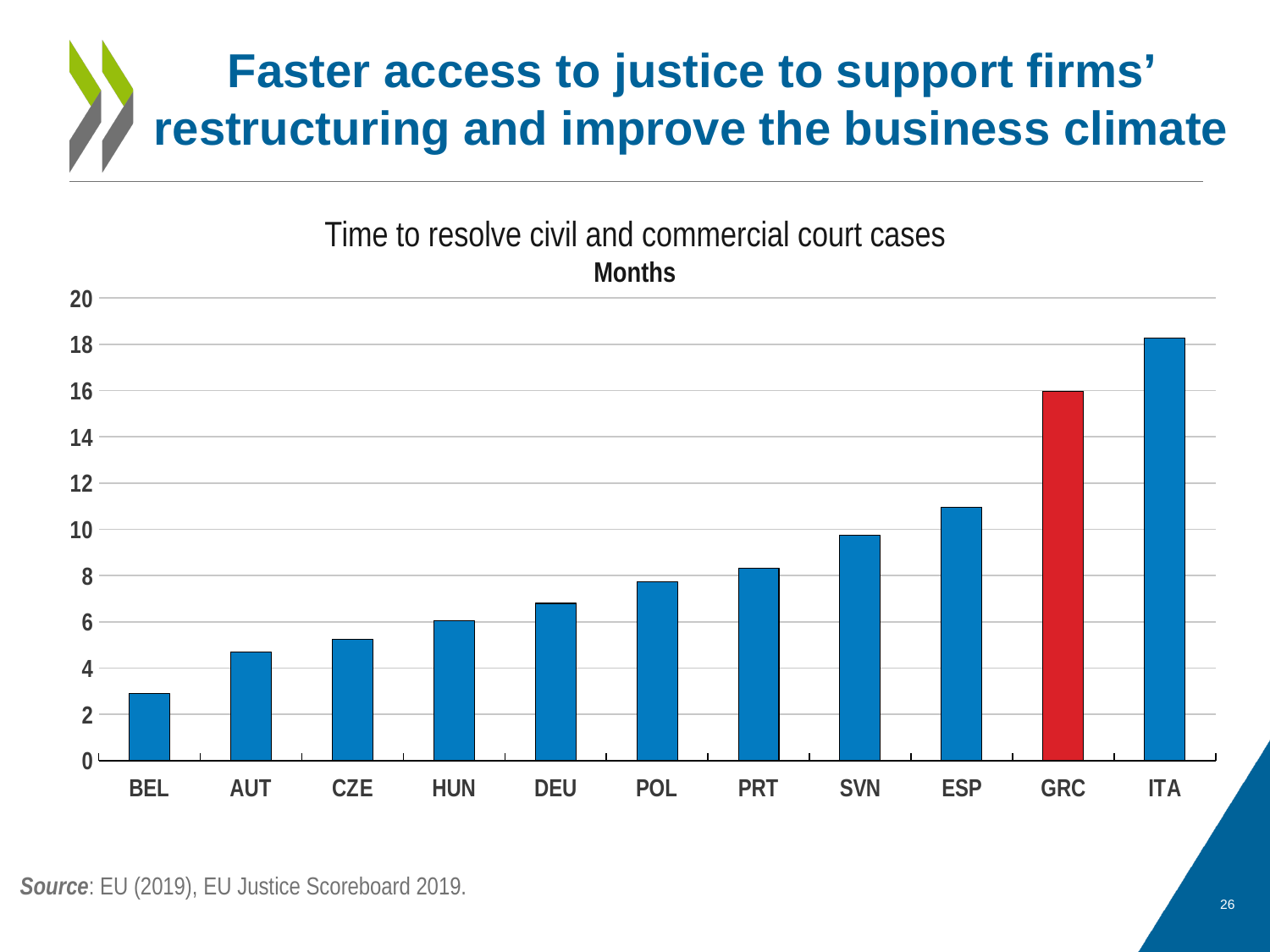
In what unit are the values on the chart measured? Months What kind of chart is shown on the slide? Bar chart Do the values rise or fall moving from left to right along the x axis? Rise Which country's bar is coloured red in the chart? GRC How many countries are shown on the x axis of the chart? 11 Is the value for ESP greater or less than 10? greater Which has a larger value, GRC or ESP? GRC Is the value for BEL greater or less than 4? less Is the value for DEU greater or less than 8? less Which country has the highest time to resolve civil and commercial court cases? ITA Which country has the lowest time to resolve civil and commercial court cases? BEL